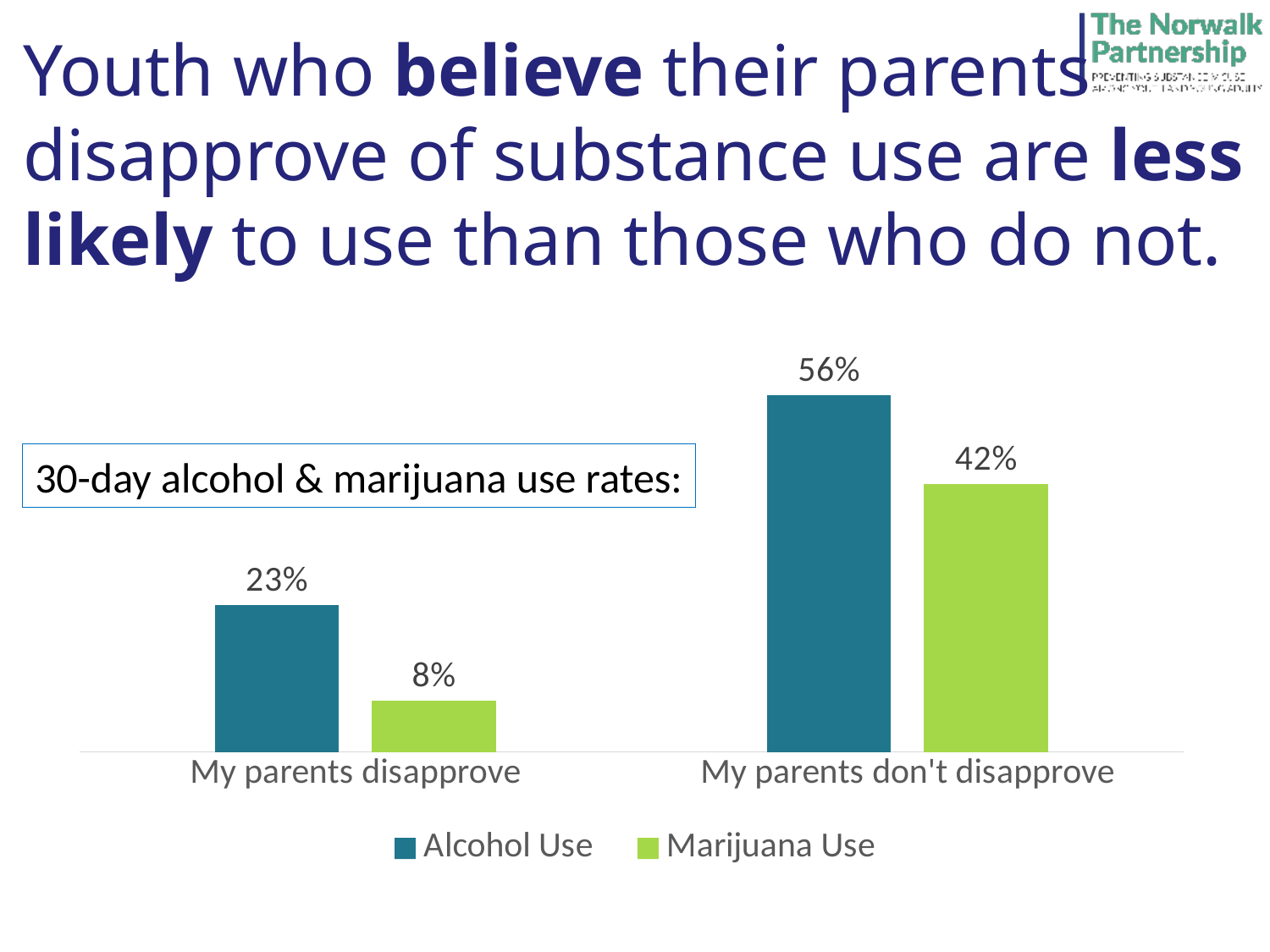
What is the marijuana use rate for the 'My parents don't disapprove' category? 42% Which is larger: marijuana use for 'My parents don't disapprove' or alcohol use for 'My parents disapprove'? Marijuana use for 'My parents don't disapprove' What is the difference between alcohol use and marijuana use in the 'My parents don't disapprove' category? 14% Which category has the highest alcohol use rate? My parents don't disapprove What is the marijuana use rate for the 'My parents disapprove' category? 8% What is the alcohol use rate for the 'My parents disapprove' category? 23% What are the two series named in the legend? Alcohol Use and Marijuana Use What kind of chart is shown on the slide? Bar chart How many series does the legend list? 2 Which series has the lowest value in the 'My parents disapprove' category? Marijuana Use How many categories are shown on the x axis? 2 What is the difference between the alcohol use rates for 'My parents don't disapprove' and 'My parents disapprove'? 33%